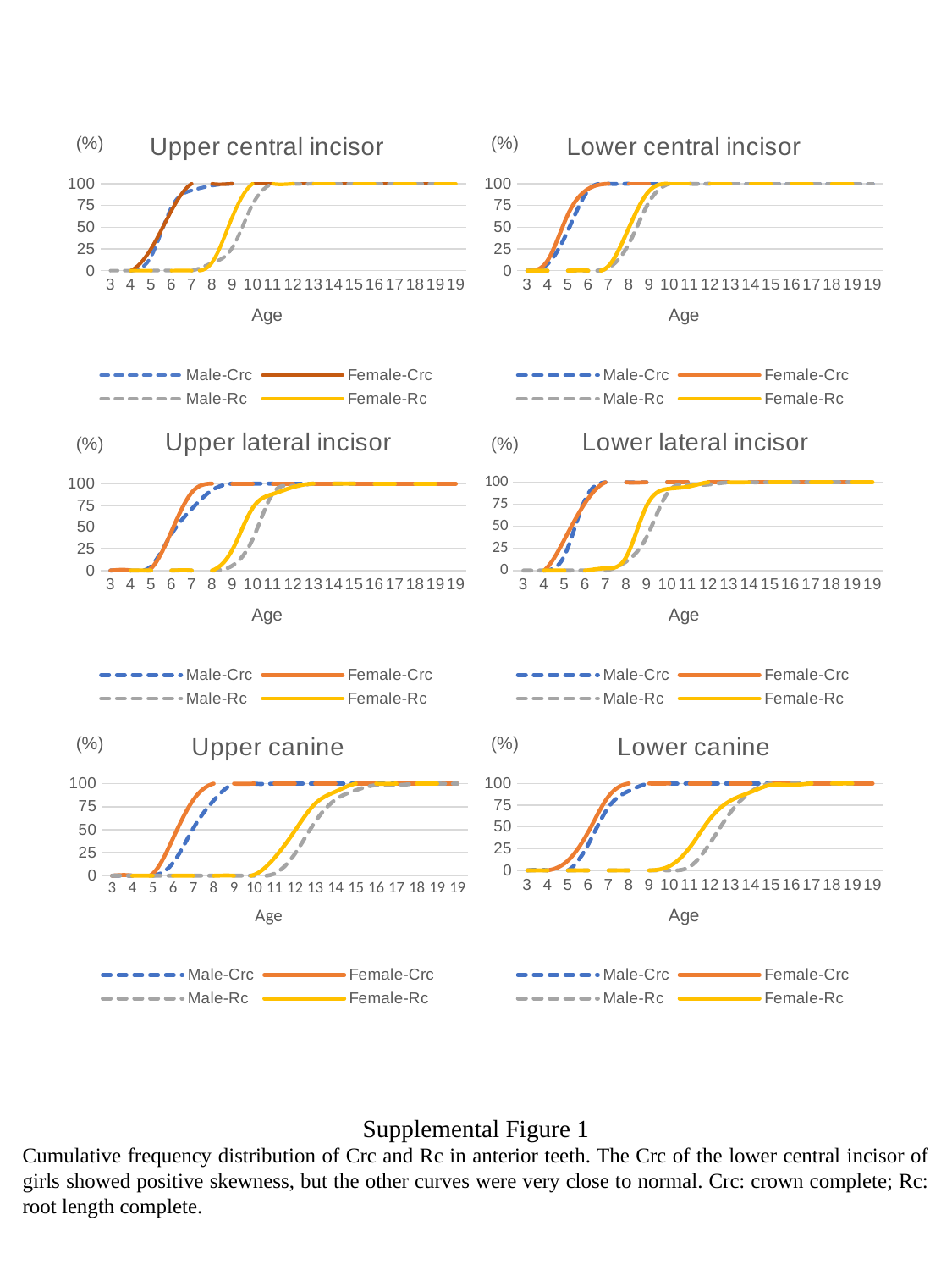
In the "Lower canine" chart, at age 12, which series has the larger value: Female-Rc or Male-Rc? Female-Rc In the "Upper canine" chart, is the value for Female-Crc at age 7 greater or less than 50? greater How many charts are shown on the slide? 6 In the "Upper canine" chart, is the value for Male-Rc at age 10 greater or less than 25? less In the "Lower central incisor" chart, is the value for Male-Crc at age 4 greater or less than 25? less What is the x-axis label of the "Upper canine" chart? Age How many series does the legend of the "Lower canine" chart list? 4 In the "Lower lateral incisor" chart, which series is drawn as a solid yellow line? Female-Rc In the "Upper canine" chart, do the values of the Female-Rc series rise or fall as age increases? rise In the "Upper canine" chart, at age 12, which series has the larger value: Female-Rc or Male-Rc? Female-Rc What kind of chart is the "Upper central incisor" chart? line chart